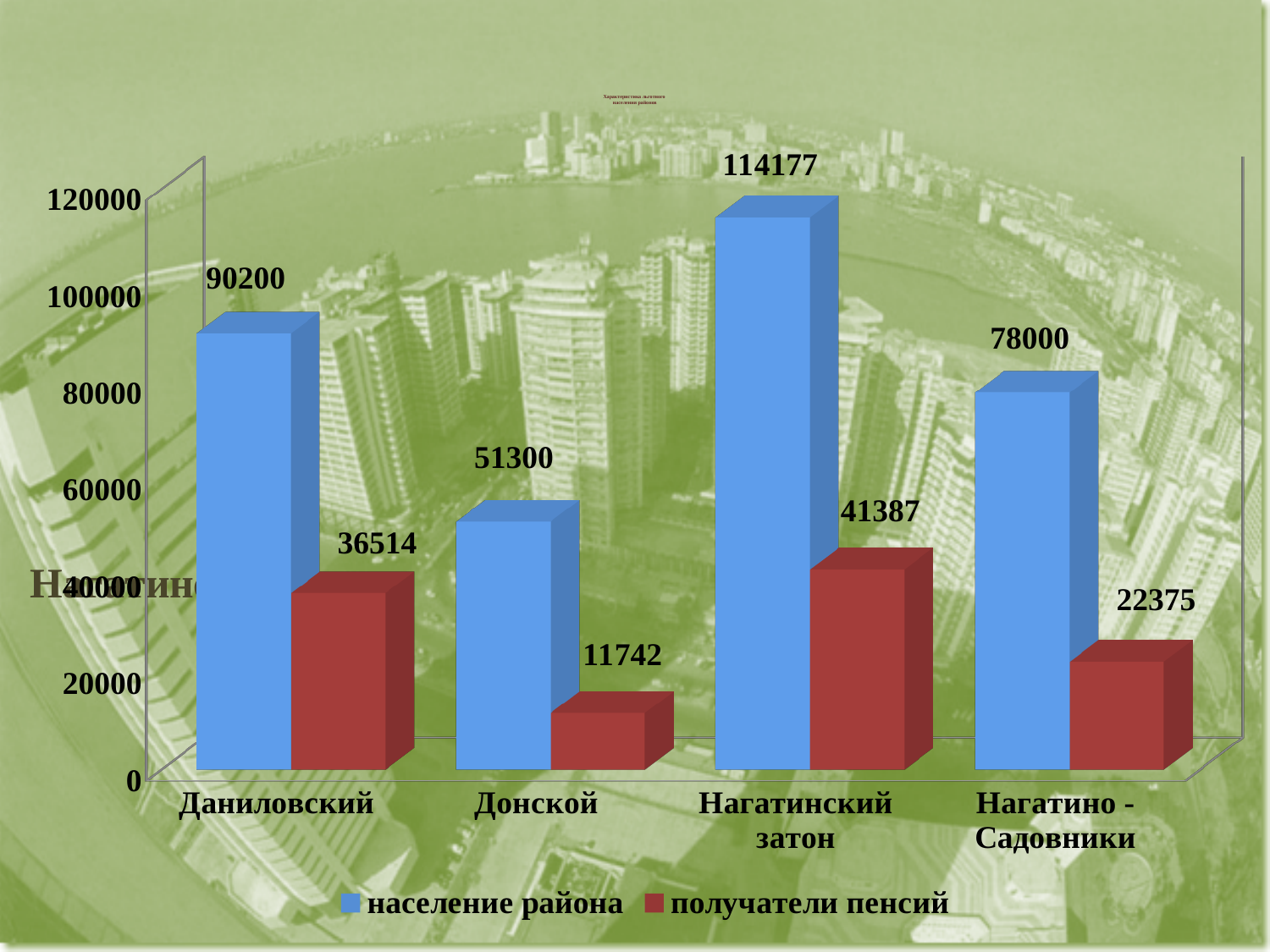
What is the value of получатели пенсий for Донской? 11742 How many series does the legend list? 2 How many categories are shown on the x axis? 4 What is the value of население района for Даниловский? 90200 Which category has the highest value for население района? Нагатинский затон Which is larger: получатели пенсий for Даниловский or получатели пенсий for Нагатино - Садовники? Даниловский What kind of chart is shown on the slide? bar chart What is the value of население района for Нагатинский затон? 114177 What is the difference between население района and получатели пенсий for Даниловский? 53686 Which category has the lowest value for получатели пенсий? Донской Which colour represents получатели пенсий in the legend? red What is the value of получатели пенсий for Нагатино - Садовники? 22375